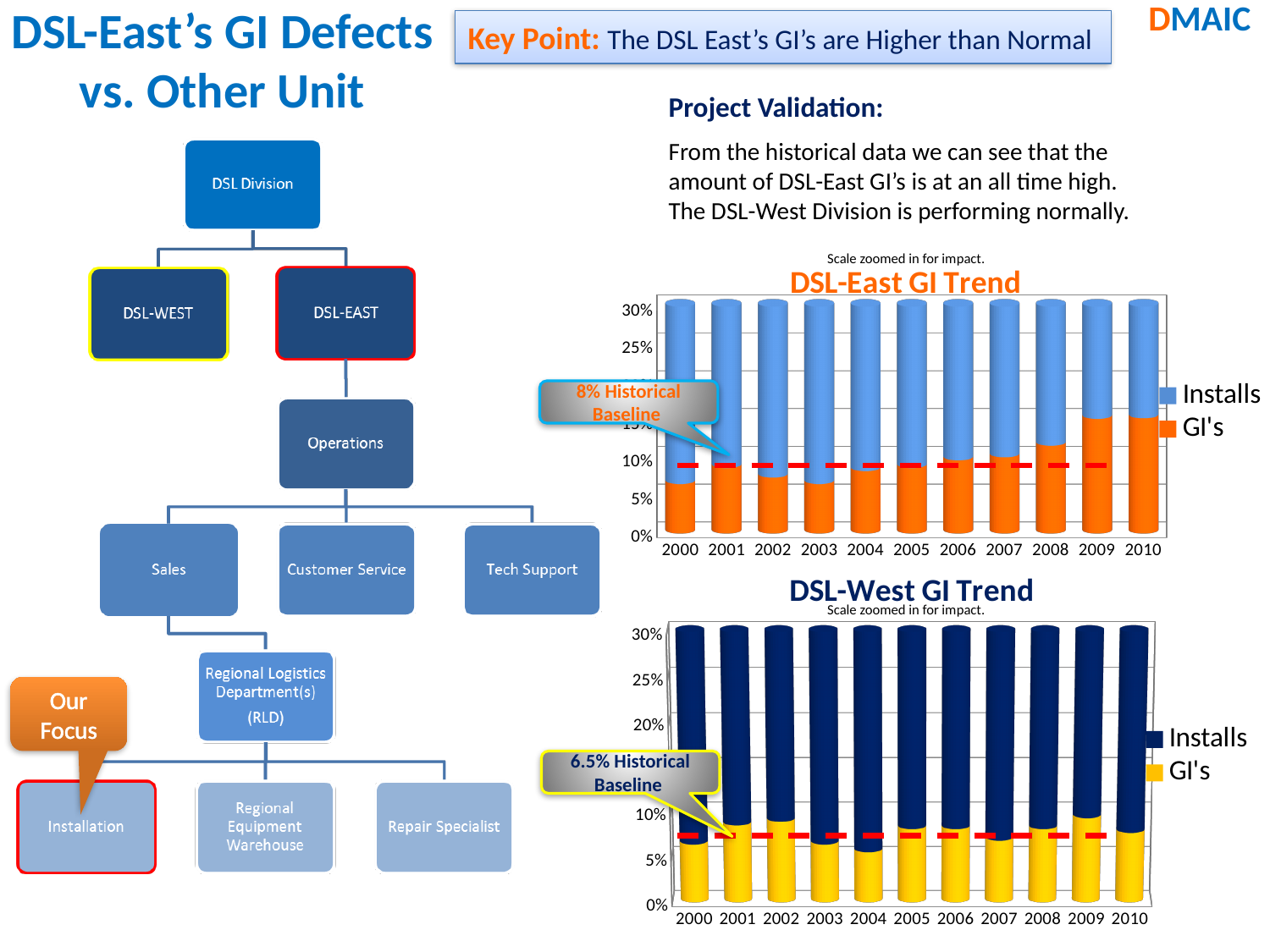
How many series does the legend of the DSL-West GI Trend chart list? 2 In the DSL-East GI Trend chart, which is larger, the GI's value for 2010 or the GI's value for 2003? 2010 In the DSL-West GI Trend chart, which is larger, the GI's value for 2002 or the GI's value for 2004? 2002 What kind of chart is the DSL-East GI Trend chart? bar chart What historical baseline is annotated on the DSL-East GI Trend chart? 8% Historical Baseline What is the first year shown on the x axis of the DSL-West GI Trend chart? 2000 What are the two legend entries in the DSL-West GI Trend chart? Installs and GI's How many years are shown on the x axis of the DSL-East GI Trend chart? 11 In the DSL-East GI Trend chart, do the GI's values generally rise or fall from 2000 to 2010? rise In the DSL-East GI Trend chart, is the GI's value for 2000 greater or less than 10%? less In the DSL-West GI Trend chart, is the GI's value for 2004 greater or less than 10%? less